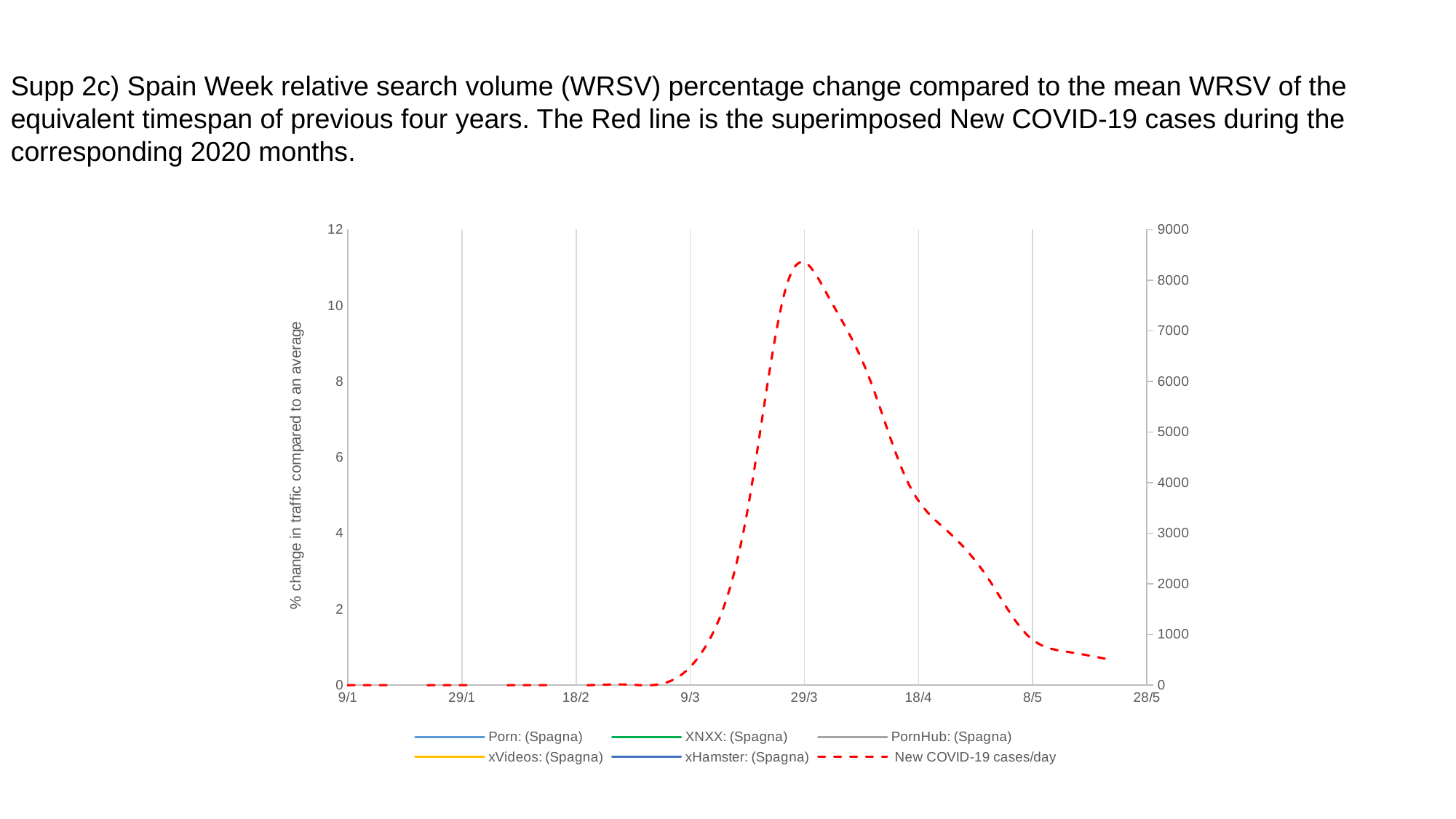
What kind of chart is shown on the slide? line chart Is the value of the New COVID-19 cases/day line at 29/3 greater or less than 7000 on the right axis? greater Around which x-axis date does the New COVID-19 cases/day line reach its peak? 29/3 Does the New COVID-19 cases/day line rise or fall between 9/3 and 29/3? rise Is the value of the New COVID-19 cases/day line at 18/4 greater or less than 3000 on the right axis? greater Is the value of the New COVID-19 cases/day line at 18/2 greater or less than 1000 on the right axis? less What is the title of the left vertical axis? % change in traffic compared to an average Which series is drawn as a red dashed line? New COVID-19 cases/day How many series does the legend list? 6 Does the New COVID-19 cases/day line rise or fall between 29/3 and 8/5? fall How many date labels are shown on the x axis? 8